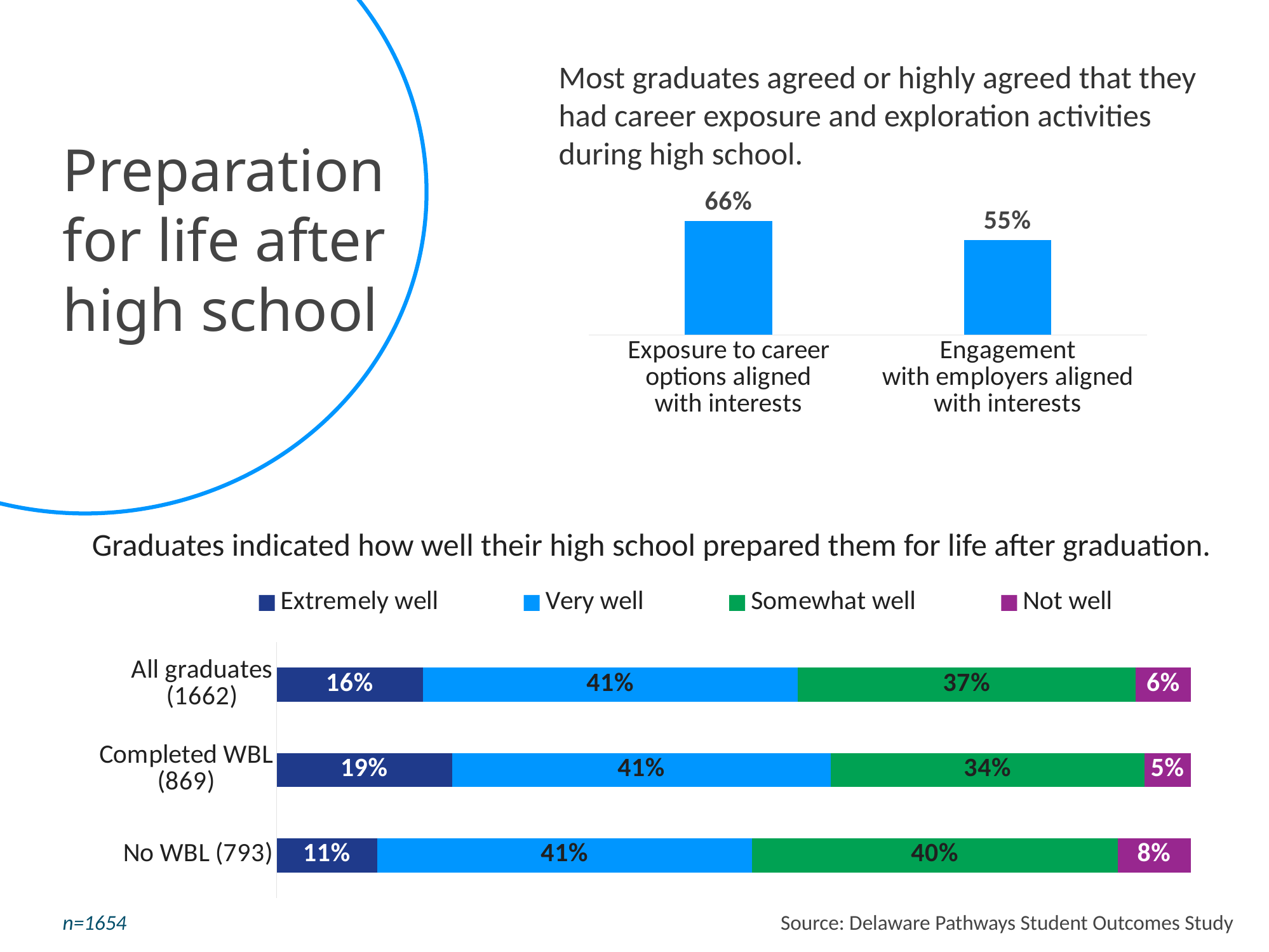
In the top chart, what is the value for engagement with employers aligned with interests? 55% In the top chart, what percentage of graduates agreed they had exposure to career options aligned with interests? 66% In the top chart, which category has the higher value? Exposure to career options aligned with interests In the bottom chart, which colour represents 'Not well'? Purple In the bottom chart, what is the difference between the 'Somewhat well' share for No WBL and for Completed WBL? 6 percentage points In the bottom chart, how many series does the legend list? 4 What kind of chart is the bottom chart? Stacked horizontal bar chart In the bottom chart, what percentage of graduates who completed WBL said their high school prepared them extremely well? 19% In the top chart, how many bars are shown? 2 In the bottom chart, what percentage of No WBL graduates said they were prepared not well? 8% In the bottom chart, which group has the lowest share answering 'Extremely well'? No WBL (793) In the top chart, what is the difference between the two bars? 11 percentage points